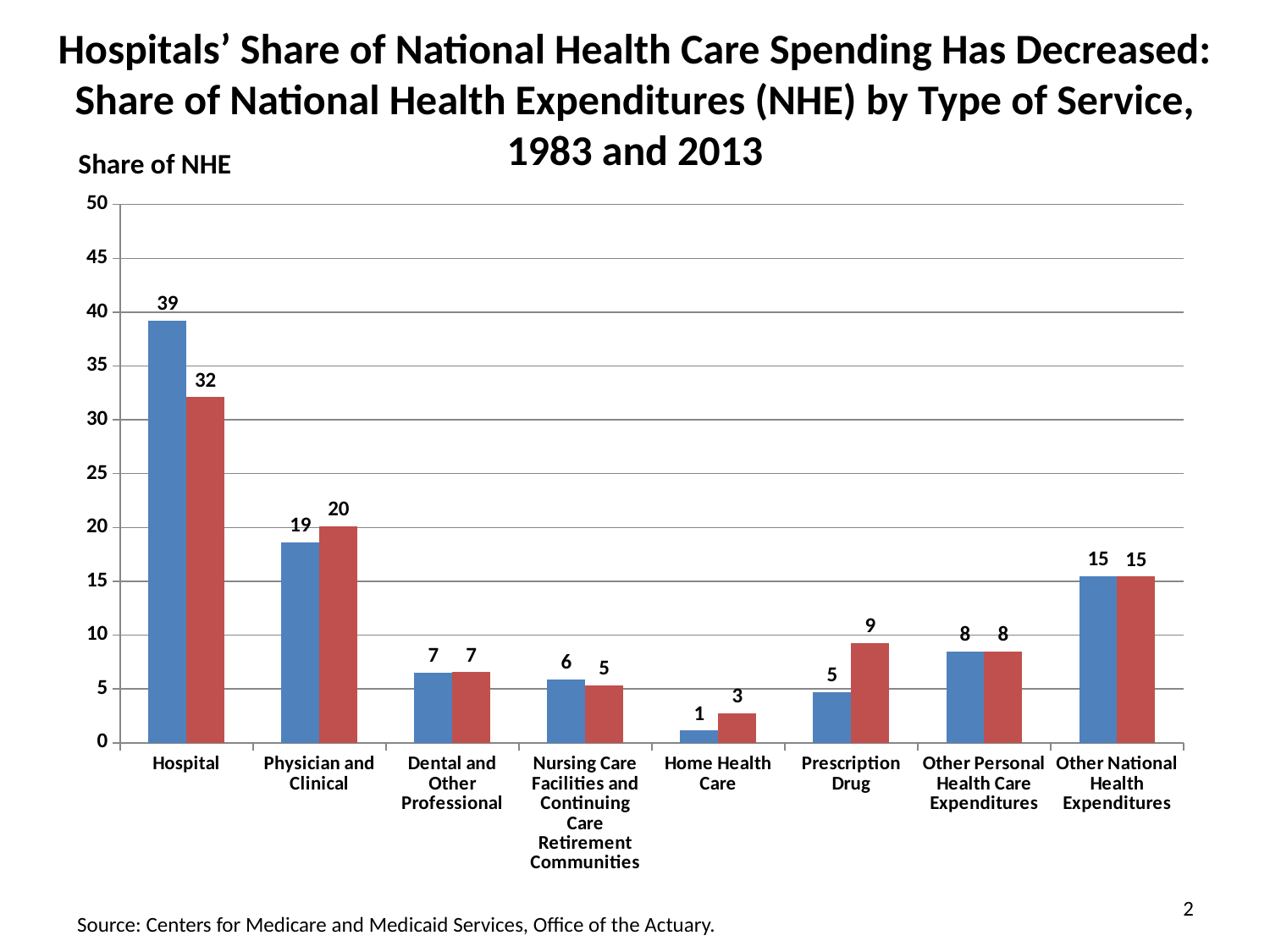
What is the value of the blue bar for Home Health Care? 1 For Prescription Drug, which is larger, the blue bar or the red bar? the red bar What kind of chart is shown on the slide? bar chart What is the value of the red bar for Other National Health Expenditures? 15 What is the value of the red bar for Prescription Drug? 9 Which category has the highest blue bar? Hospital What is the value of the blue bar for Hospital? 39 What is the difference between the blue bar and the red bar for Hospital? 7 Is the value of the red bar for Hospital greater or less than 30? greater How many categories are shown on the x axis? 8 What is the label on the vertical axis of the chart? Share of NHE Which category has the lowest red bar? Home Health Care